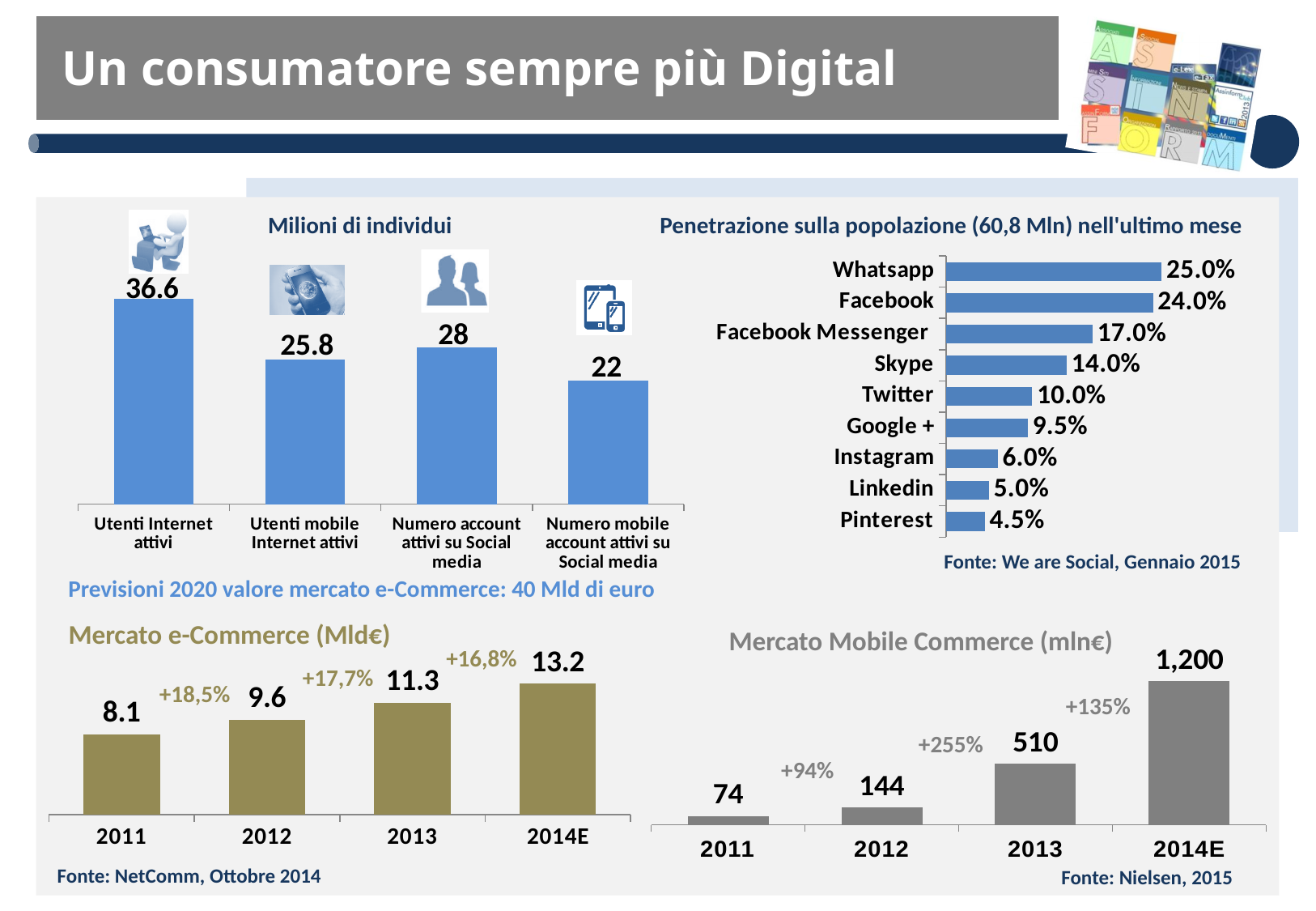
In the 'Milioni di individui' chart, what is the value for 'Utenti Internet attivi'? 36.6 In the 'Milioni di individui' chart, what is the difference between 'Numero account attivi su Social media' and 'Utenti mobile Internet attivi'? 2.2 How many platforms are shown in the 'Penetrazione sulla popolazione' chart? 9 In the 'Mercato Mobile Commerce (mln€)' chart, what is the value for 2014E? 1,200 In the 'Penetrazione sulla popolazione' chart, which is larger, Twitter or Google +? Twitter In the 'Penetrazione sulla popolazione' chart, what is the value for Skype? 14.0% What kind of chart is the 'Penetrazione sulla popolazione' chart? Bar chart In the 'Milioni di individui' chart, which category has the lowest value? Numero mobile account attivi su Social media In the 'Mercato e-Commerce (Mld€)' chart, what is the value for 2013? 11.3 In the 'Mercato e-Commerce (Mld€)' chart, do the values rise or fall from 2011 to 2014E? Rise In the 'Mercato Mobile Commerce (mln€)' chart, what is the difference between 2013 and 2012? 366 In the 'Penetrazione sulla popolazione' chart, which platform has the highest penetration? Whatsapp